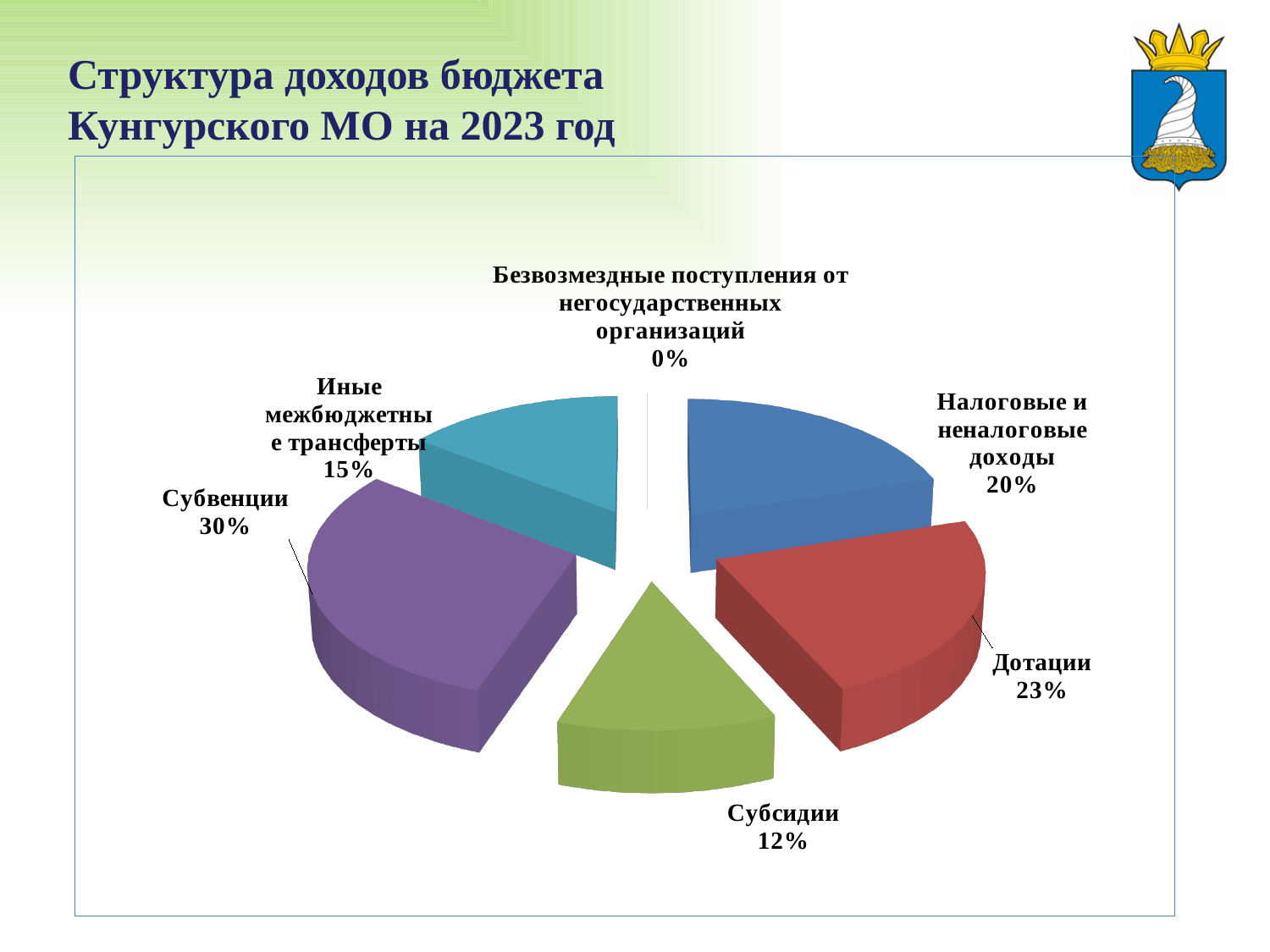
What share of the pie does Субвенции have? 30% What is the difference between the shares of Субвенции and Субсидии? 18% What is the value shown for Дотации? 23% What is the value shown for Субсидии? 12% What kind of chart is shown on the slide? Pie chart Which category has the smallest share of the pie? Безвозмездные поступления от негосударственных организаций Which category has the largest share of the pie? Субвенции What is the value shown for Безвозмездные поступления от негосударственных организаций? 0% Which is larger, the share for Дотации or the share for Налоговые и неналоговые доходы? Дотации What is the value shown for Иные межбюджетные трансферты? 15% How many categories are labelled on the pie chart? 6 What is the value shown for Налоговые и неналоговые доходы? 20%